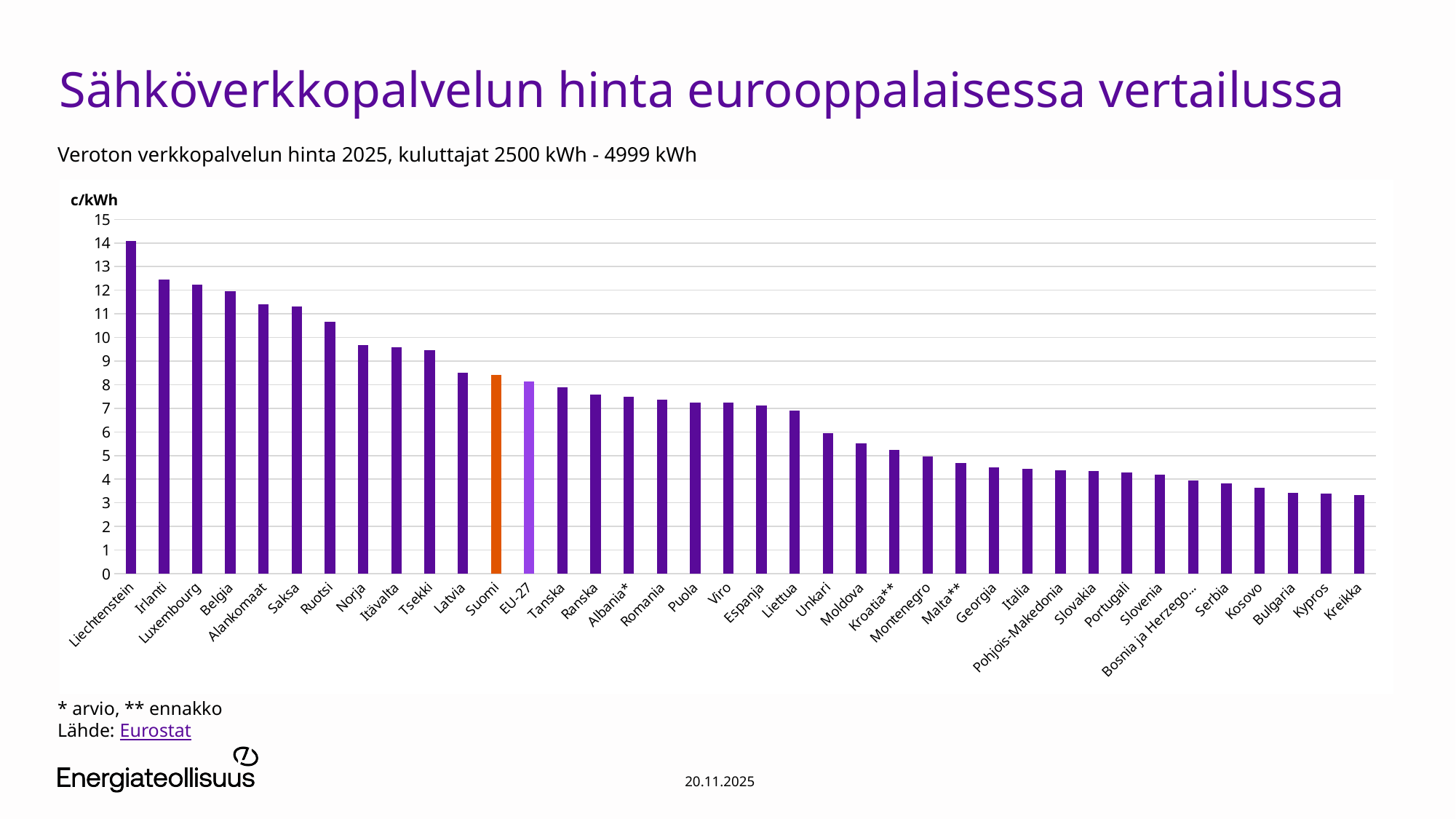
Is the value for Suomi greater or less than 8 c/kWh? greater Which country has the lowest network service price in the chart? Kreikka What kind of chart is shown on the slide? bar chart Is the value for Ruotsi greater or less than 10 c/kWh? greater Is the value for Kreikka greater or less than 4 c/kWh? less How many bars (countries/regions) are plotted in the chart? 38 Which country has the highest network service price in the chart? Liechtenstein What unit is shown on the y axis of the chart? c/kWh Which has the larger value, Saksa or Ruotsi? Saksa Do the values rise or fall from left to right along the x axis? fall